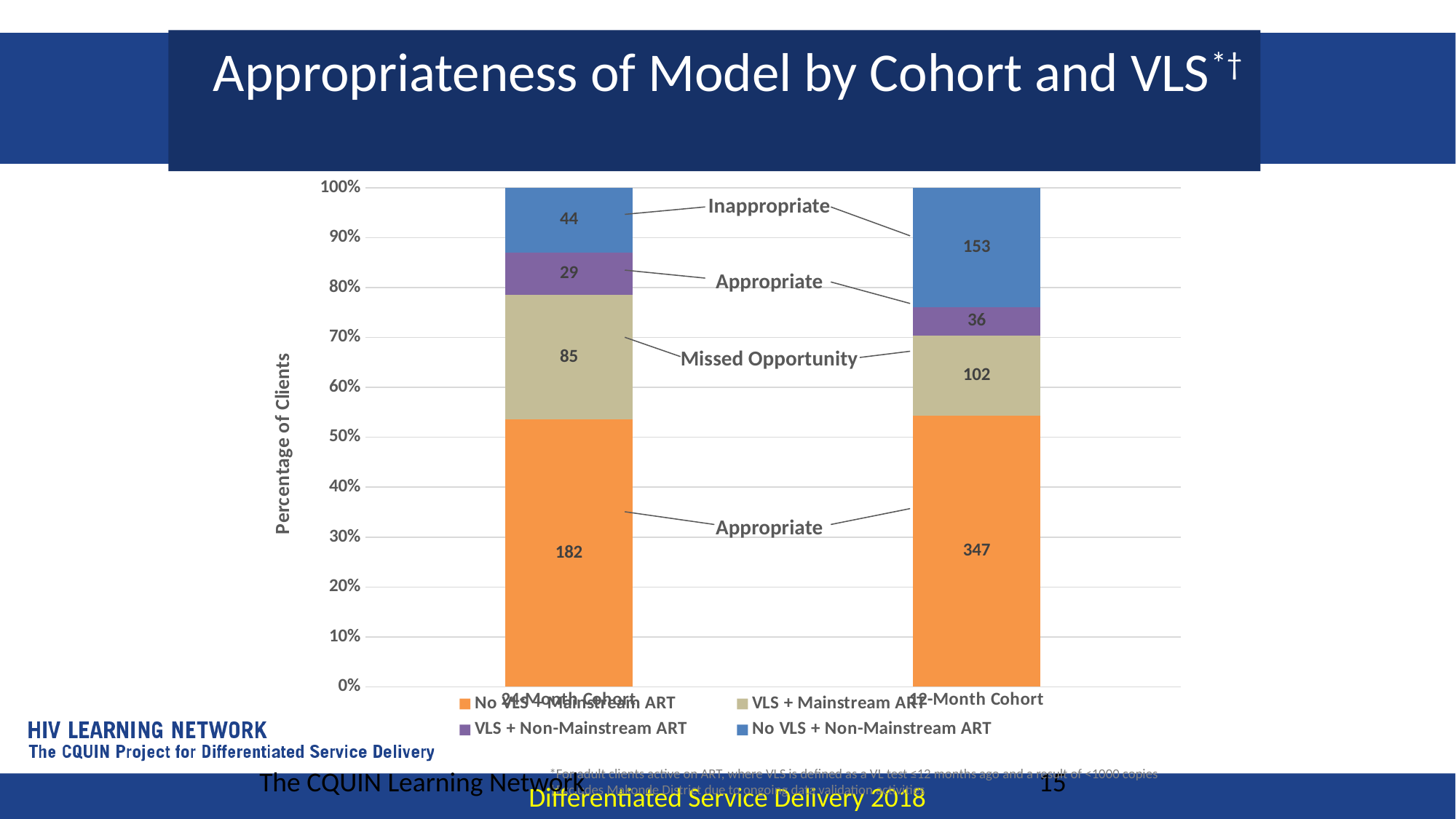
Which cohort has the larger data label for No VLS + Non-Mainstream ART? 12-Month Cohort Which series has the largest data label in the 12-Month Cohort bar? No VLS + Mainstream ART What type of chart is shown on the slide? Stacked bar chart What is the data label for No VLS + Mainstream ART in the 24-Month Cohort bar? 182 What is the data label for VLS + Non-Mainstream ART in the 24-Month Cohort bar? 29 Which series has the smallest data label in the 24-Month Cohort bar? VLS + Non-Mainstream ART How many series does the legend list? 4 What is the data label for VLS + Mainstream ART in the 12-Month Cohort bar? 102 What is the sum of the data labels in the 24-Month Cohort bar? 340 What is the difference between the No VLS + Mainstream ART labels for the 12-Month Cohort and the 24-Month Cohort? 165 What is the data label for No VLS + Non-Mainstream ART in the 12-Month Cohort bar? 153 What is the label on the vertical axis of the chart? Percentage of Clients